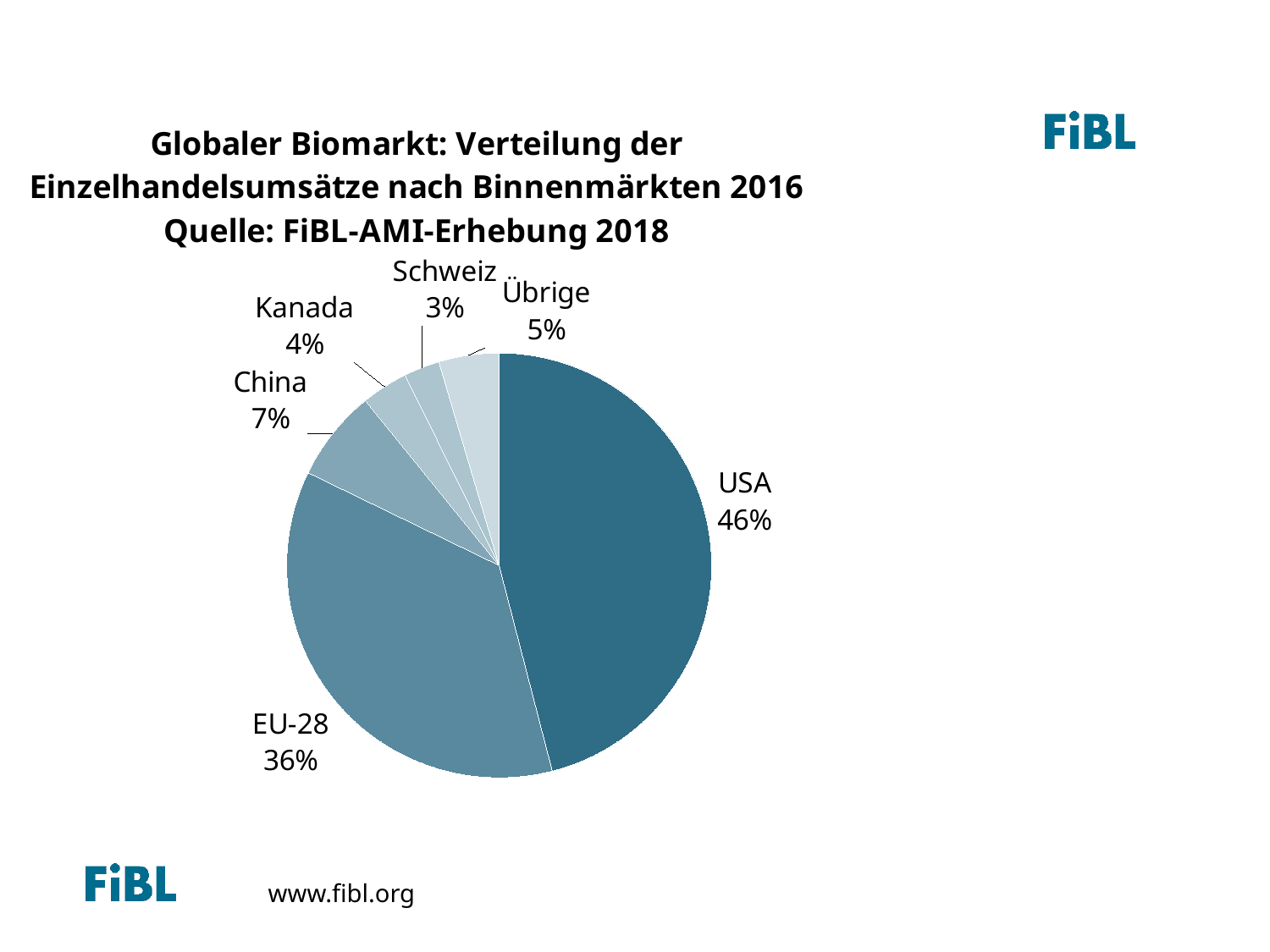
What kind of chart is shown on the slide? Pie chart What is the value shown for EU-28? 36% What share of the pie does the USA hold? 46% What is the difference between the USA share and the EU-28 share? 10 percentage points Which category has the smallest slice of the pie? Schweiz What is the value shown for China? 7% How many slices does the pie chart have? 6 Which category has the largest slice of the pie? USA What is the value shown for Schweiz? 3% What source is cited in the chart title? FiBL-AMI-Erhebung 2018 Which is larger, the share for China or the share for Übrige? China What is the value shown for Kanada? 4%